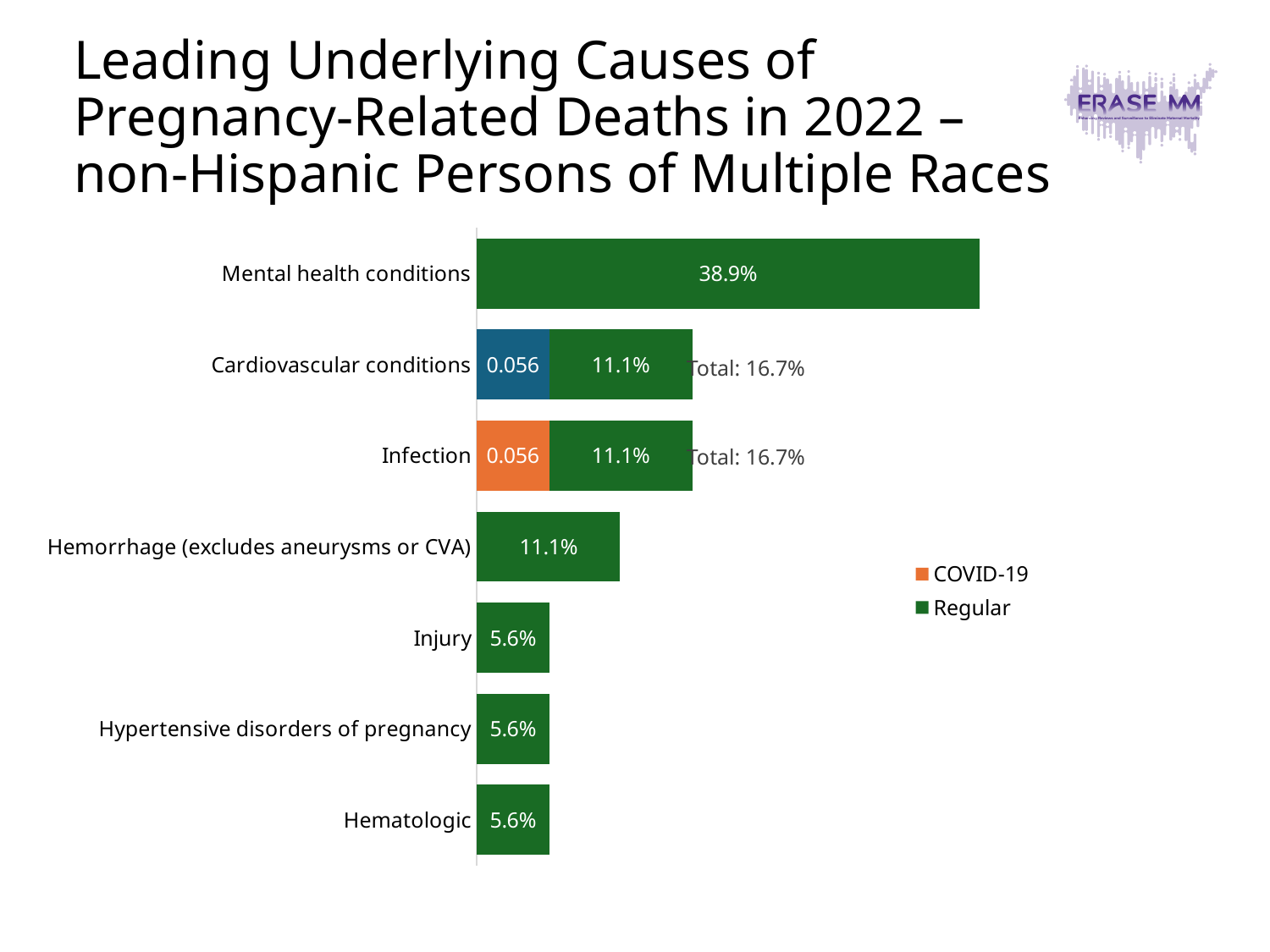
What is the difference between the Mental health conditions value and the Hemorrhage (excludes aneurysms or CVA) value? 27.8% How many series does the legend list? 2 Which series does the orange colour represent in the legend? COVID-19 How many categories are shown on the chart? 7 What is the COVID-19 value shown for Infection? 0.056 What is the value for Injury? 5.6% What kind of chart is shown on the slide? Bar chart What total is printed next to the Infection bar? Total: 16.7% What is the Regular value for Hemorrhage (excludes aneurysms or CVA)? 11.1% Which category has the highest value? Mental health conditions Which is larger, the value for Hemorrhage (excludes aneurysms or CVA) or the value for Hematologic? Hemorrhage (excludes aneurysms or CVA) What is the Regular value for Mental health conditions? 38.9%